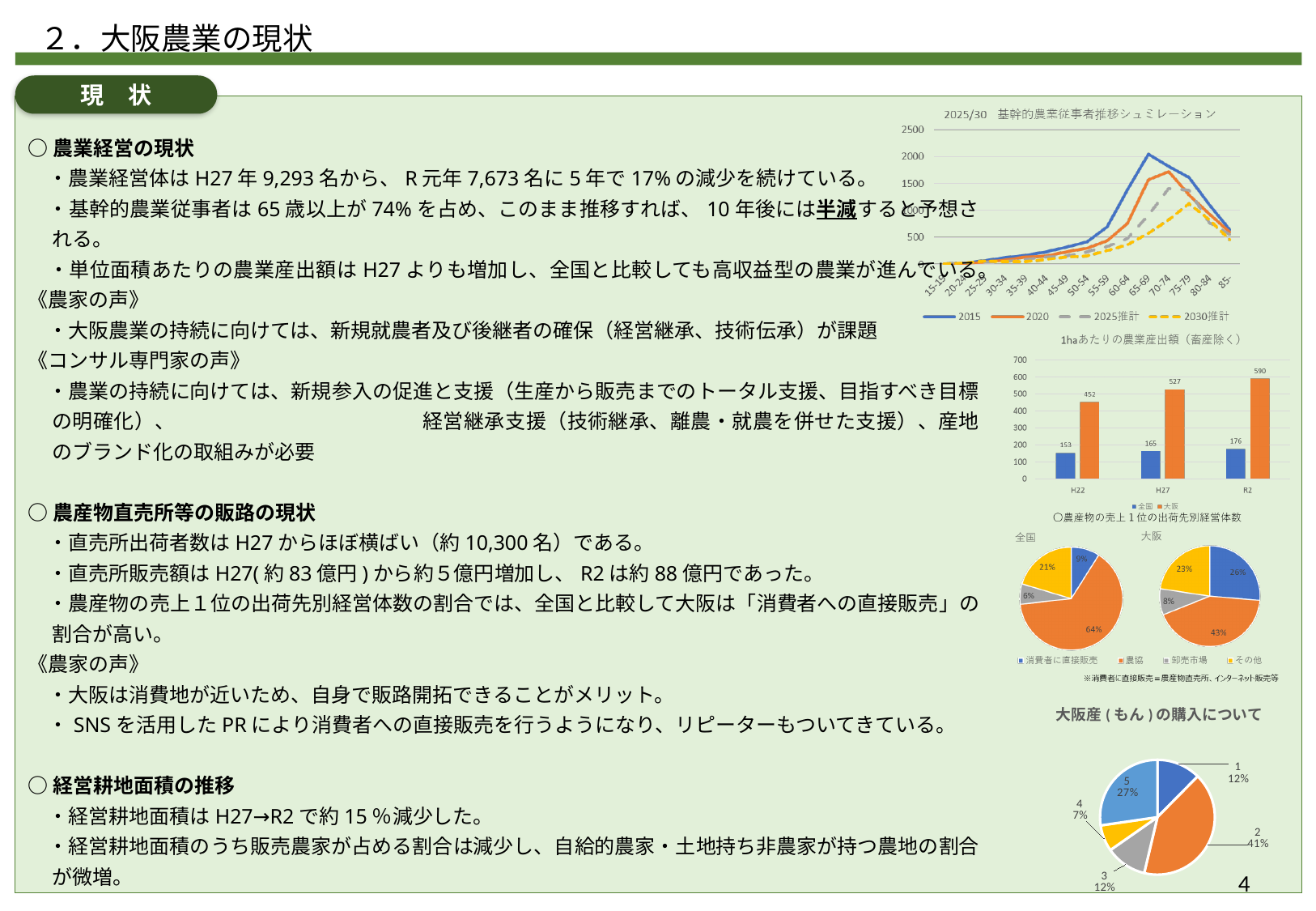
In the pie chart titled 大阪産(もん)の購入について, what share does category 5 have? 27% In the bar chart titled 1haあたりの農業産出額（畜産除く）, which year has the highest value for 大阪? R2 In the bar chart titled 1haあたりの農業産出額（畜産除く）, what is the value for 全国 in H22? 153 In the 全国 pie chart under 農産物の売上１位の出荷先別経営体数, what share does 農協 have? 64% In the pie chart titled 大阪産(もん)の購入について, which category has the largest share? 2 In the 大阪 pie chart under 農産物の売上１位の出荷先別経営体数, what share does 消費者に直接販売 have? 26% How many series does the legend of the bar chart titled 1haあたりの農業産出額（畜産除く） list? 2 Which is larger: the 消費者に直接販売 share in the 全国 pie chart or in the 大阪 pie chart? 大阪 In the bar chart titled 1haあたりの農業産出額（畜産除く）, what is the difference between 大阪 and 全国 in H27? 362 In the bar chart titled 1haあたりの農業産出額（畜産除く）, do the 全国 values rise or fall from H22 to R2? rise How many series does the legend of the line chart titled 2025/30 基幹的農業従事者推移シュミレーション list? 4 In the bar chart titled 1haあたりの農業産出額（畜産除く）, what is the value for 大阪 in R2? 590